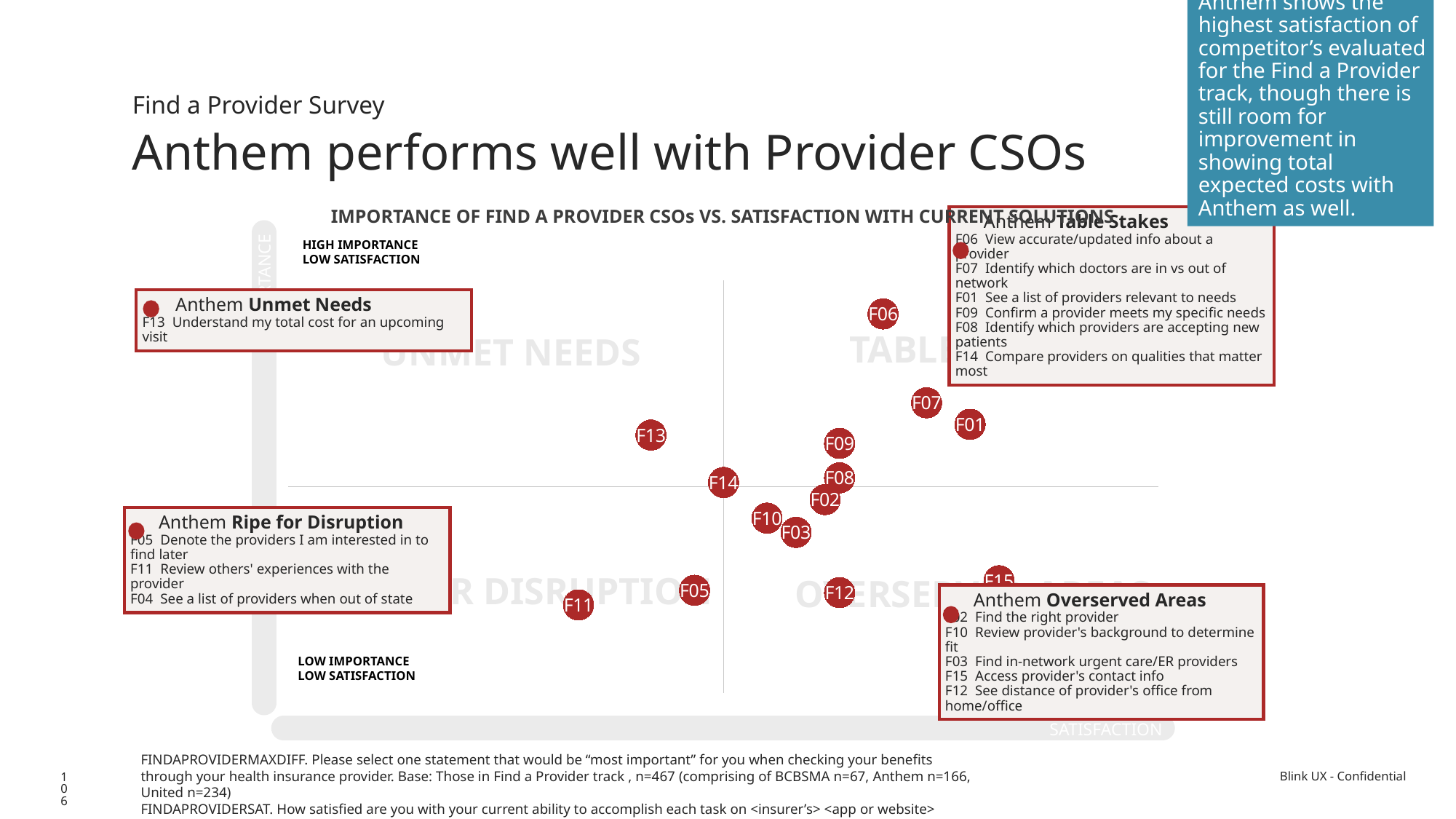
Which point has higher satisfaction, F01 or F07? F01 Which point has higher importance, F06 or F13? F06 What is the title of the chart? IMPORTANCE OF FIND A PROVIDER CSOs VS. SATISFACTION WITH CURRENT SOLUTIONS Which point is plotted with the lowest importance (lowest on the vertical axis)? F11 Which point is plotted furthest to the left, i.e. with the lowest satisfaction? F11 What kind of chart is shown on the slide? Scatter chart What label is shown on the horizontal axis of the chart? SATISFACTION Which point is plotted furthest to the right, i.e. with the highest satisfaction? F15 Which point is plotted with the highest importance (highest on the vertical axis)? F06 Which quadrant of the chart is point F12 plotted in? Overserved Areas Which quadrant of the chart is point F13 plotted in? Unmet Needs Which quadrant of the chart is point F05 plotted in? Ripe for Disruption